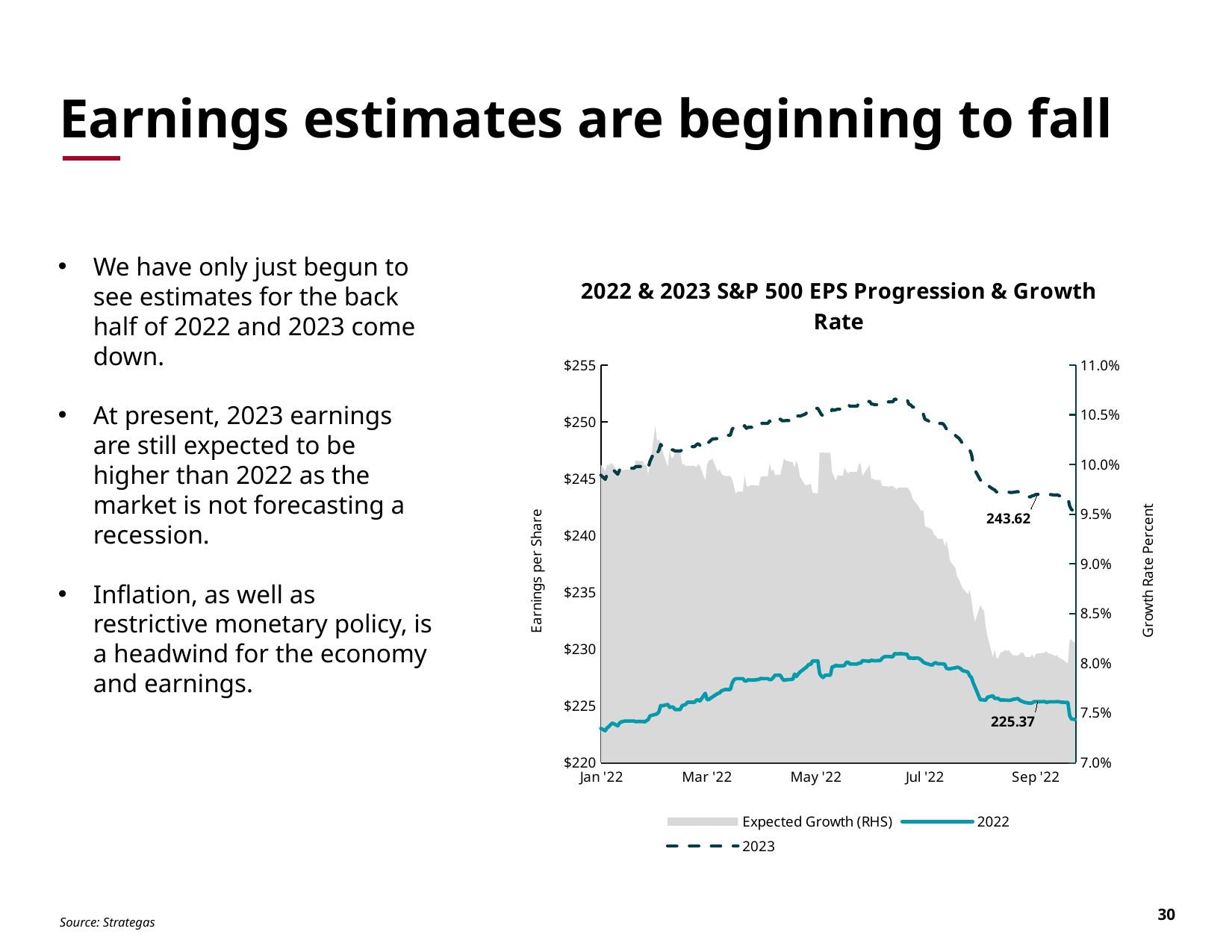
Is the value of the 2023 line at Jul '22 greater or less than $245? greater What kind of chart is shown on the slide? combination area and line chart What is the title of the chart? 2022 & 2023 S&P 500 EPS Progression & Growth Rate Is the Expected Growth (RHS) value at Sep '22 greater or less than 8.5%? less Which series has the higher labelled value near Sep '22, 2022 or 2023? 2023 What is the label of the right-hand vertical axis? Growth Rate Percent Does the 2022 line rise or fall between Jul '22 and Sep '22? fall What is the labelled value on the 2022 line near Sep '22? 225.37 What is the labelled value on the 2023 line near Sep '22? 243.62 How many series does the legend list? 3 Is the value of the 2022 line at Jan '22 greater or less than $225? less What is the difference between the labelled 2023 value (243.62) and the labelled 2022 value (225.37)? 18.25